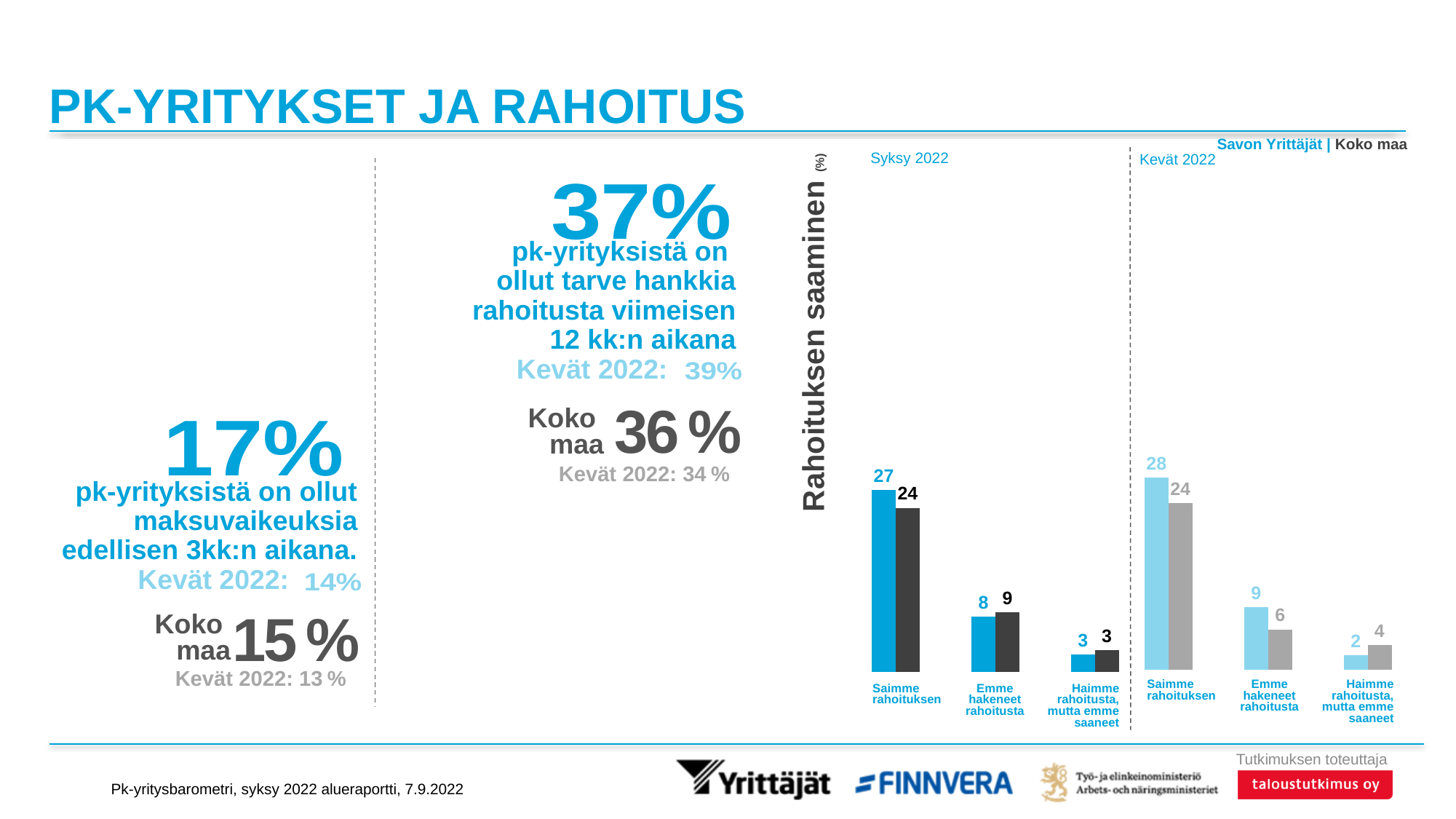
What type of chart is the Rahoituksen saaminen chart? Bar chart What are the two time periods shown in the Rahoituksen saaminen chart? Syksy 2022 and Kevät 2022 In the Rahoituksen saaminen chart, which category has the lowest Koko maa value in Kevät 2022? Haimme rahoitusta, mutta emme saaneet In the Rahoituksen saaminen chart, how many categories are shown for Syksy 2022? 3 In the Rahoituksen saaminen chart, for 'Emme hakeneet rahoitusta' in Syksy 2022, which is larger: Savon Yrittäjät or Koko maa? Koko maa In the Rahoituksen saaminen chart, what is the Savon Yrittäjät value for 'Haimme rahoitusta, mutta emme saaneet' in Kevät 2022? 2 In the Rahoituksen saaminen chart, what is the difference between the Savon Yrittäjät and Koko maa values for 'Saimme rahoituksen' in Kevät 2022? 4 In the Rahoituksen saaminen chart, what is the Koko maa value for 'Emme hakeneet rahoitusta' in Kevät 2022? 6 In the Rahoituksen saaminen chart, what is the Koko maa value for 'Saimme rahoituksen' in Syksy 2022? 24 In the Rahoituksen saaminen chart, what is the Savon Yrittäjät value for 'Saimme rahoituksen' in Syksy 2022? 27 In the Rahoituksen saaminen chart, which category has the highest Savon Yrittäjät value in Syksy 2022? Saimme rahoituksen